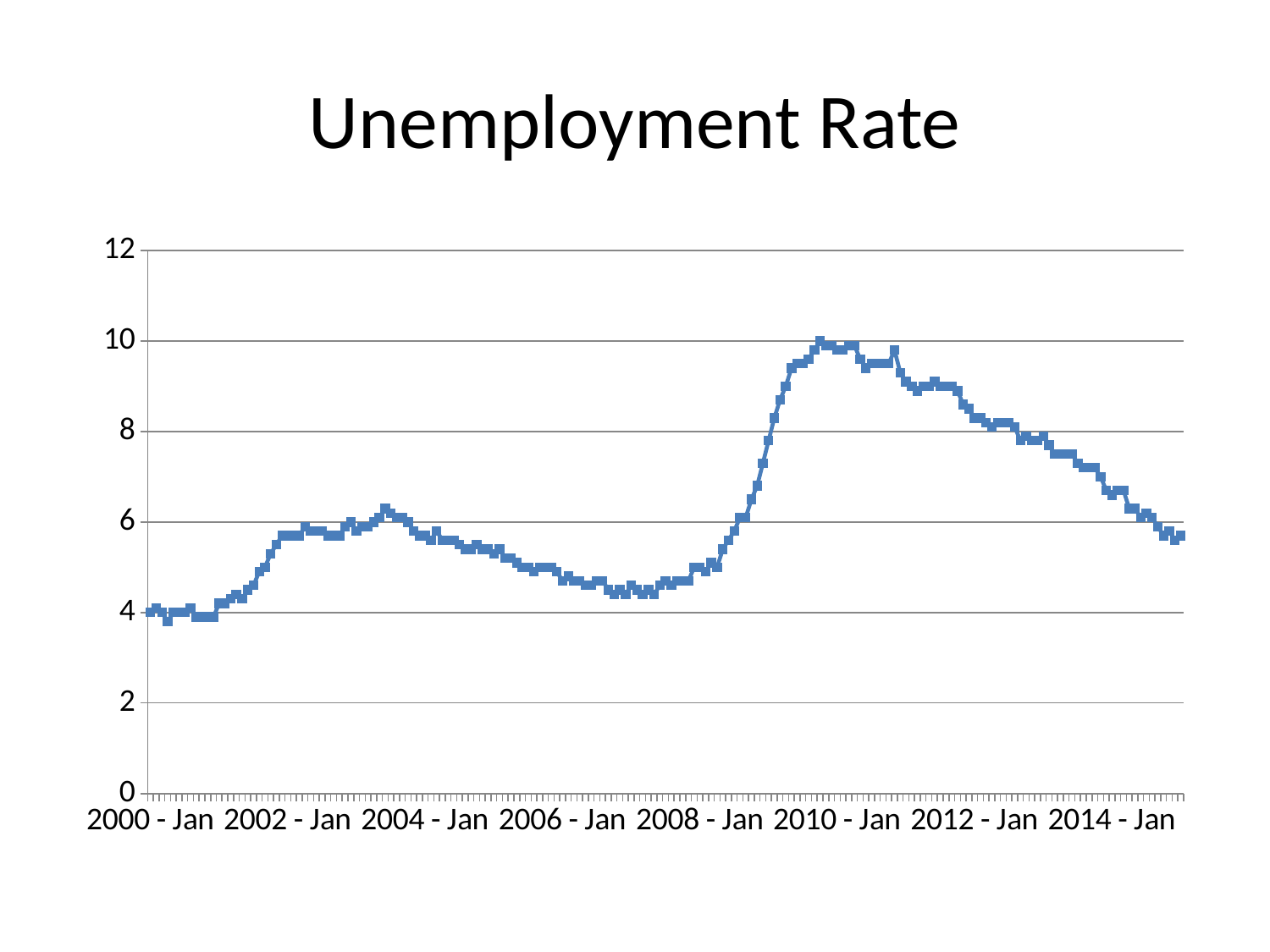
Which is larger, the value at 2010 - Jan or the value at 2000 - Jan? 2010 - Jan Does the unemployment rate rise or fall between 2010 - Jan and 2014 - Jan? fall What is the title of the chart? Unemployment Rate Is the value at 2006 - Jan greater or less than 4? greater How many labels are shown on the x axis? 8 Is the value at 2014 - Jan greater or less than 8? less Is the value at 2008 - Jan greater or less than 6? less What kind of chart is shown on the slide? line chart Does the unemployment rate rise or fall between 2008 - Jan and 2010 - Jan? rise